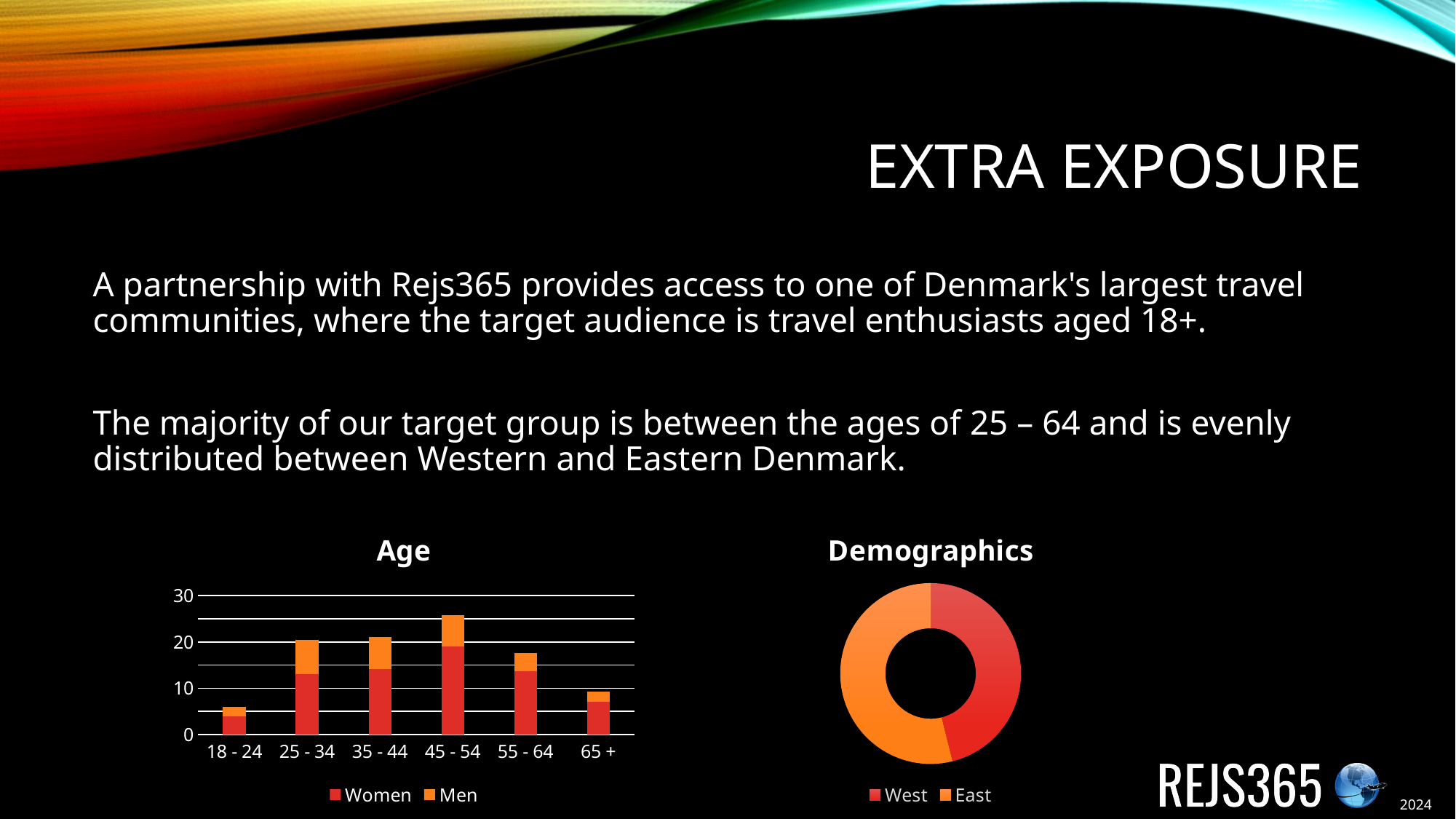
What kind of chart is the Demographics chart? doughnut chart What kind of chart is the Age chart? bar chart How many series does the legend of the Age chart list? 2 Which age group has the shortest stacked bar in the Age chart? 18 - 24 In the Age chart, is the stacked bar for 45 - 54 taller or shorter than the bar for 18 - 24? taller In the Age chart, which series is shown in orange? Men How many entries does the legend of the Demographics chart list? 2 In the Age chart, is the total value for 18 - 24 greater or less than 10? less How many age categories are shown on the x axis of the Age chart? 6 In the Age chart, is the total value for 45 - 54 greater or less than 20? greater Which age group has the tallest stacked bar in the Age chart? 45 - 54